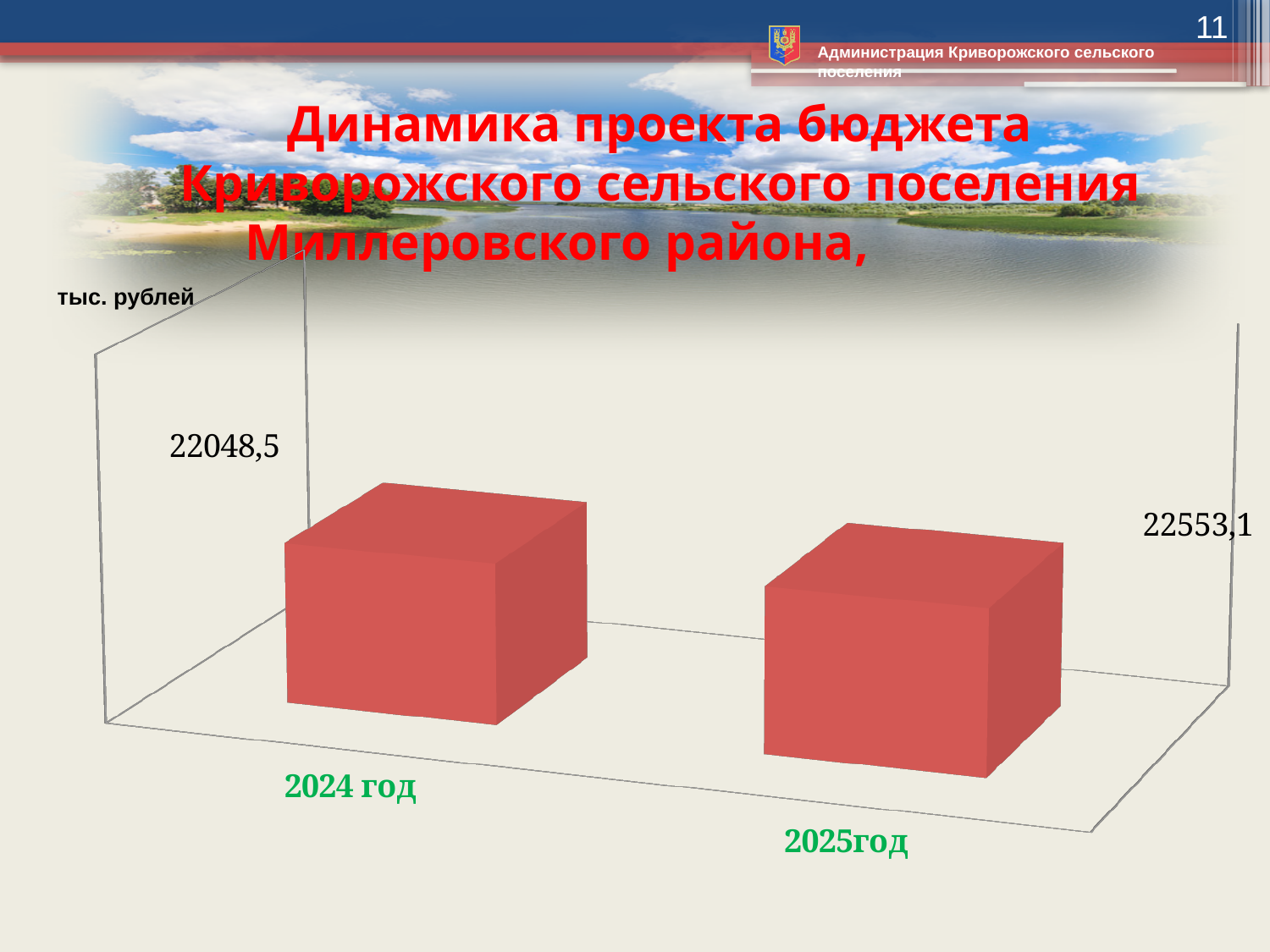
What kind of chart is shown on the slide? bar chart How many categories are shown in the chart? 2 What unit is indicated for the chart values? тыс. рублей Do the values rise or fall from 2024 год to 2025год? rise Which year has the lower value? 2024 год Which year has the higher value? 2025год Is the value for 2025год larger or smaller than the value for 2024 год? larger What is the value for 2025год? 22553,1 What is the difference between the values for 2025год and 2024 год? 504,6 What colour are the bars in the chart? red What is the value for 2024 год? 22048,5